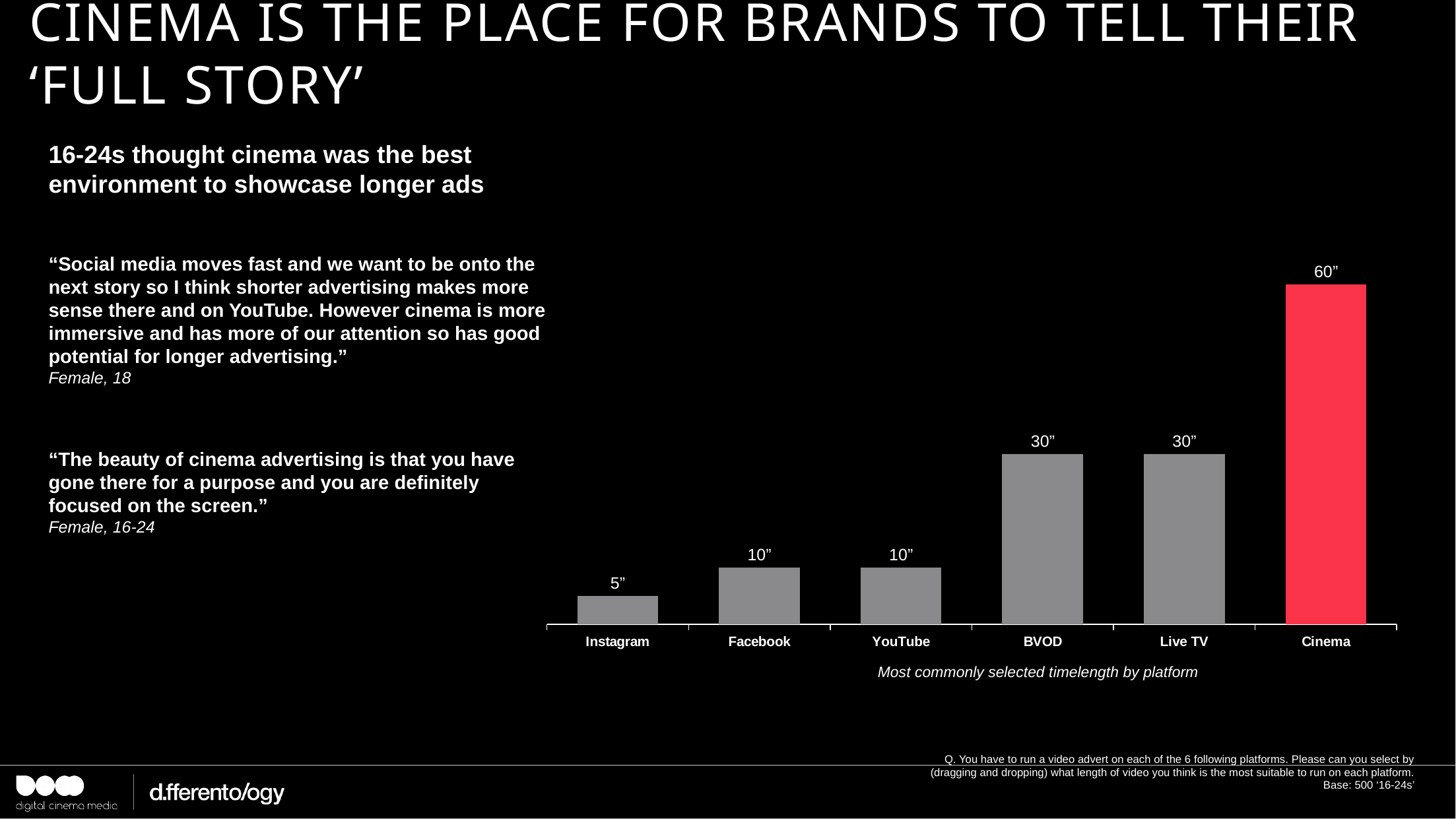
Which bar on the chart is coloured red rather than grey? Cinema Which platform has the lowest most commonly selected timelength? Instagram What is the most commonly selected timelength for Instagram? 5” Do the values rise or fall moving from Instagram to Cinema along the x axis? Rise What is the most commonly selected timelength for Facebook? 10” What kind of chart is shown on the slide? Bar chart How many platforms are shown on the chart? 6 What is the difference between the timelength for Cinema and the timelength for Live TV? 30” What is the most commonly selected timelength for Cinema? 60” What is the most commonly selected timelength for BVOD? 30” Which platform has the highest most commonly selected timelength? Cinema Which has a longer most commonly selected timelength, YouTube or BVOD? BVOD